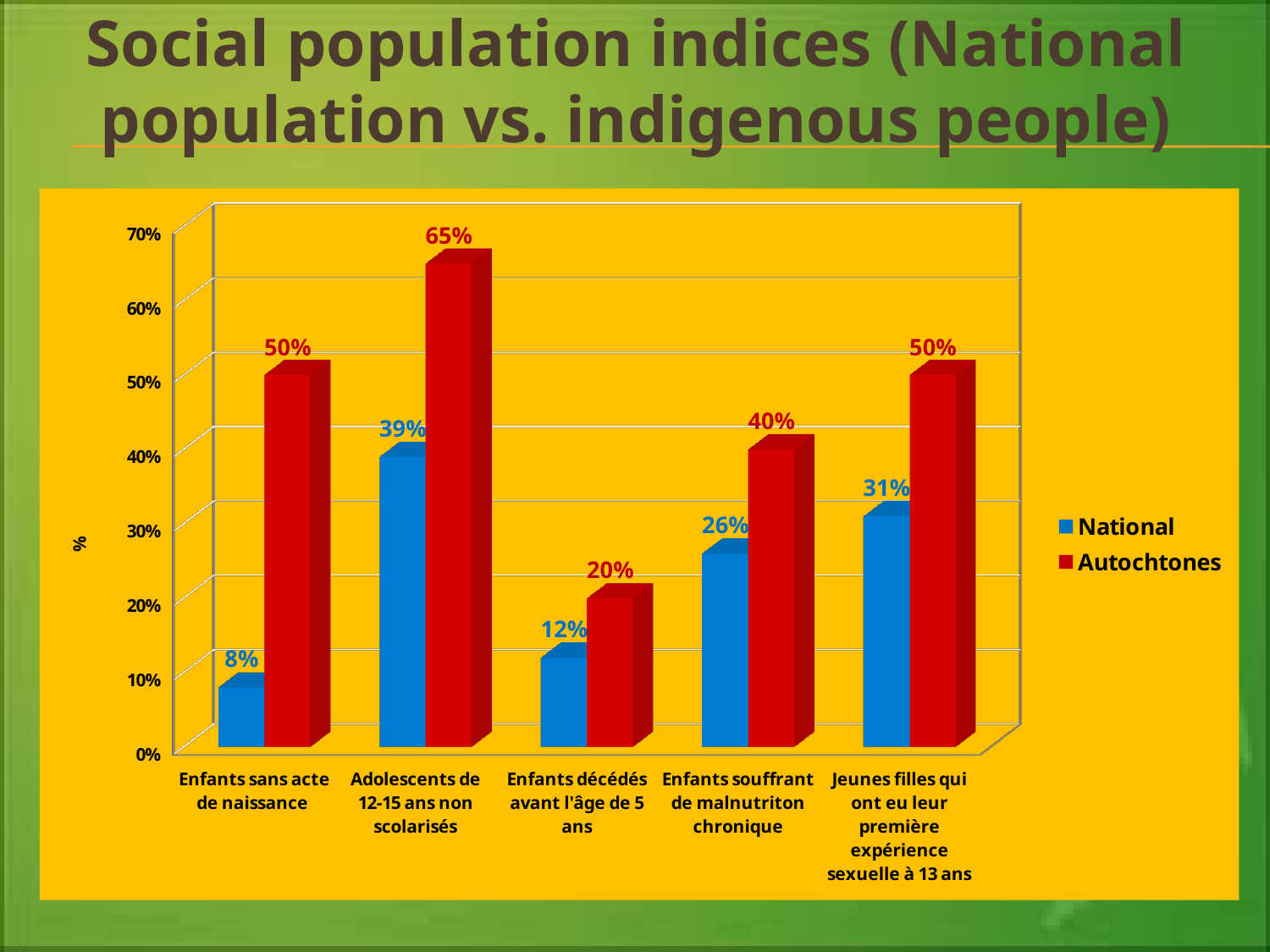
What is the Autochtones value for "Enfants décédés avant l'âge de 5 ans"? 20% What is the Autochtones value for "Adolescents de 12-15 ans non scolarisés"? 65% How many series does the legend list? 2 Which is larger: the National value for "Adolescents de 12-15 ans non scolarisés" or the National value for "Jeunes filles qui ont eu leur première expérience sexuelle à 13 ans"? Adolescents de 12-15 ans non scolarisés What is the difference between the Autochtones and National values for "Enfants sans acte de naissance"? 42% What is the difference between the Autochtones and National values for "Jeunes filles qui ont eu leur première expérience sexuelle à 13 ans"? 19% Which category has the lowest National value? Enfants sans acte de naissance Which category has the highest Autochtones value? Adolescents de 12-15 ans non scolarisés What kind of chart is shown on the slide? Bar chart What is the National value for "Enfants souffrant de malnutriton chronique"? 26% How many categories are shown on the x axis? 5 What is the National value for "Enfants sans acte de naissance"? 8%